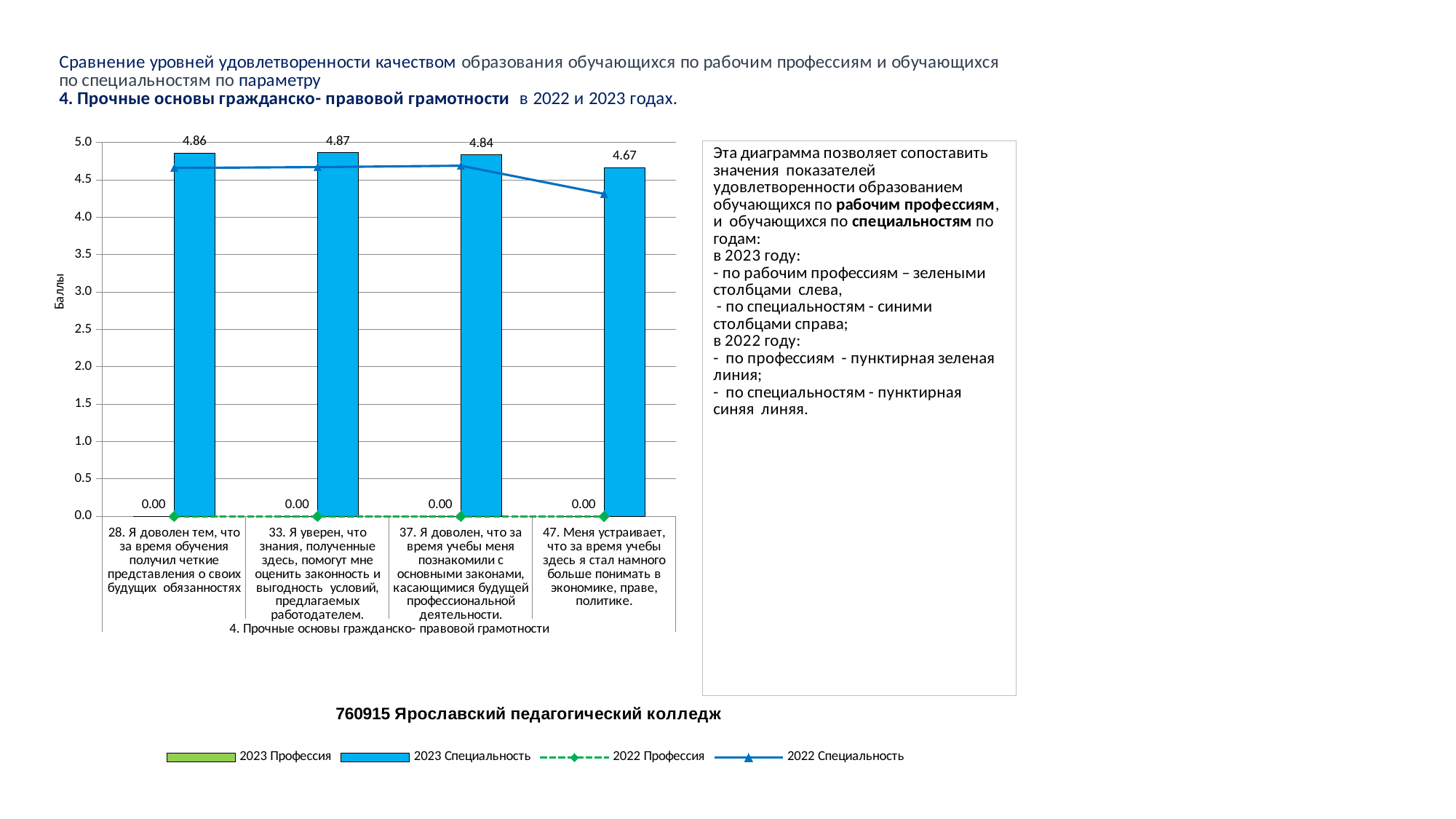
What is the label of the vertical axis of the chart? Баллы How many categories are shown on the x axis of the chart? 4 What is the value of the 2023 Специальность bar for category 47 (Меня устраивает, что за время учебы здесь я стал намного больше понимать в экономике, праве, политике)? 4.67 Is the 2022 Специальность line value for category 28 greater or less than 4.5? greater Is the 2022 Специальность line value for category 47 greater or less than 4.5? less How many series does the chart legend list? 4 Which category has the highest 2023 Специальность value? 33. Я уверен, что знания, полученные здесь, помогут мне оценить законность и выгодность условий, предлагаемых работодателем. What is the value of the 2023 Специальность bar for category 37 (Я доволен, что за время учебы меня познакомили с основными законами)? 4.84 What value is labelled for the 2023 Профессия series in each category? 0.00 What is the difference between the 2023 Специальность values for category 33 and category 47? 0.20 Which category has the lowest 2023 Специальность value? 47. Меня устраивает, что за время учебы здесь я стал намного больше понимать в экономике, праве, политике. What is the value of the 2023 Специальность bar for category 28 (Я доволен тем, что за время обучения получил четкие представления о своих будущих обязанностях)? 4.86